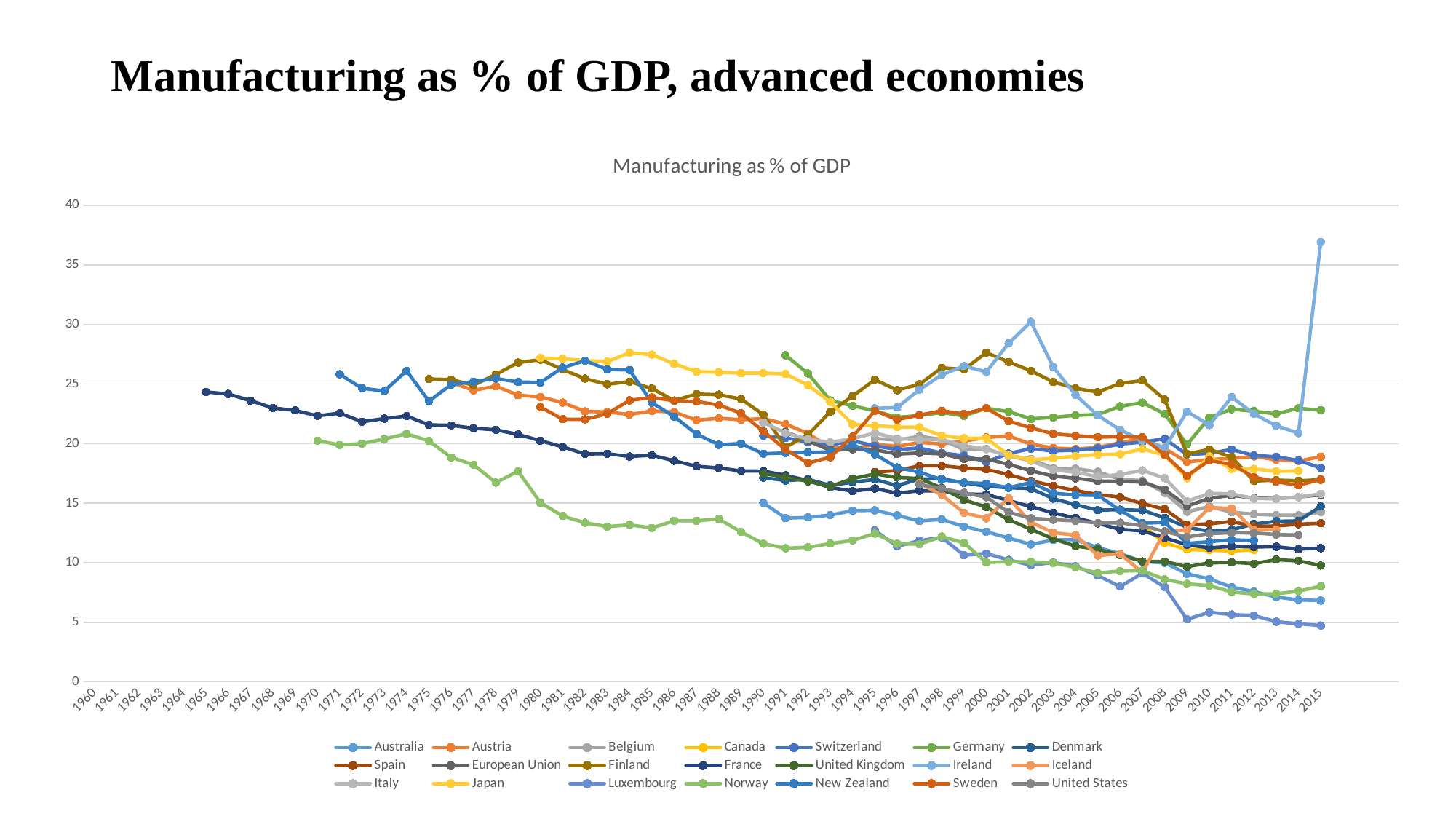
Which series has the highest value in 2015? Ireland Is the value for Germany in 2015 greater or less than 20? greater What is the title of the chart? Manufacturing as % of GDP Does the value for France rise or fall from 1965 to 2015? fall Does the value for Norway rise or fall from 1970 to 2015? fall Is the value for Norway in 2015 greater or less than 10? less How many series does the legend list? 21 What kind of chart is shown on the slide? line chart What is the first year shown on the x axis? 1960 Is the highest value plotted for 2015 greater or less than 35? greater How many years are plotted along the x axis? 56